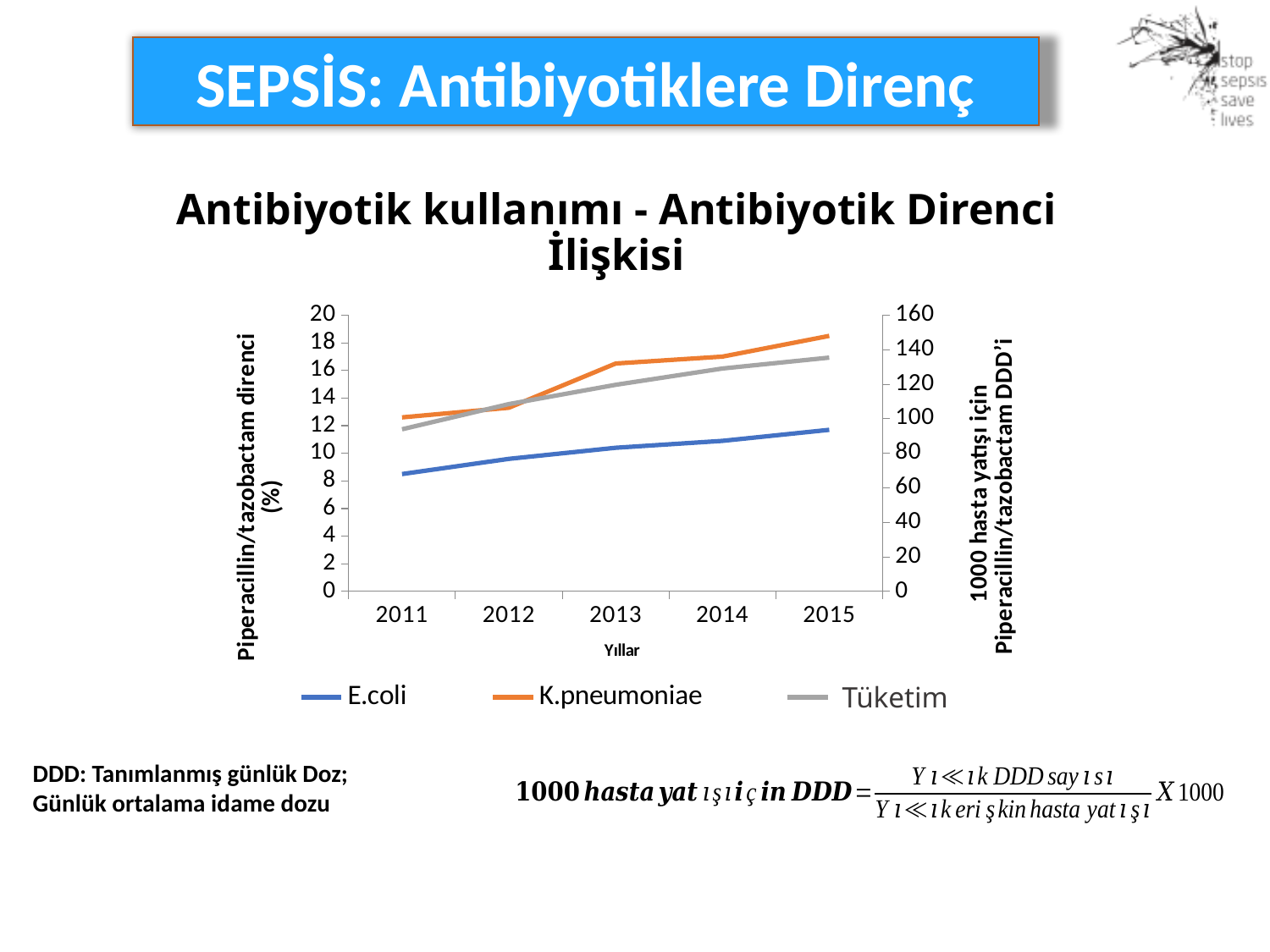
How many years are shown on the x axis of the chart? 5 In which year is the K.pneumoniae value highest? 2015 Is the E.coli value for 2015 greater or less than 14? less Is the E.coli value for 2011 greater or less than 10? less Is the K.pneumoniae value for 2015 greater or less than 16? greater How many series does the chart legend list? 3 Which is larger in 2013, the E.coli value or the K.pneumoniae value? K.pneumoniae In which year is the E.coli value lowest? 2011 What is the label of the x axis of the chart? Yıllar What kind of chart is shown on the slide? line chart Does the E.coli line rise or fall from 2011 to 2015? rise Does the K.pneumoniae line rise or fall from 2011 to 2015? rise